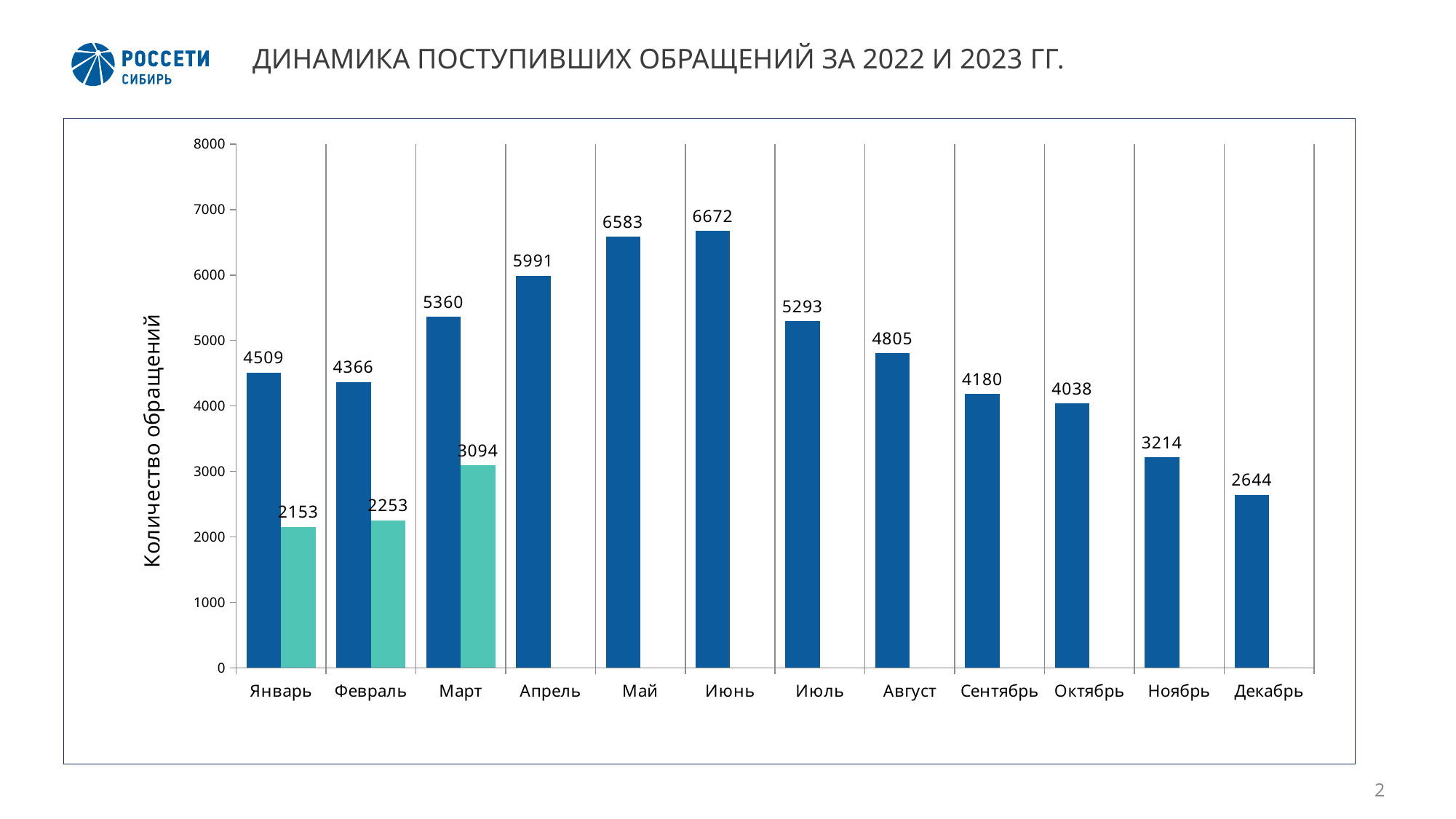
What is the value of the teal bar for Март? 3094 How many months are shown on the x axis? 12 What is the difference between the dark blue and teal bars for Январь? 2356 What is the value of the dark blue bar for Июнь? 6672 What type of chart is shown on the slide? bar chart Which is larger, the dark blue bar for Июль or the dark blue bar for Август? Июль What is the label of the vertical axis? Количество обращений Is the value of the dark blue bar for Ноябрь greater or less than 3000? greater Which month has the lowest dark blue bar? Декабрь Which month has the highest dark blue bar? Июнь What is the difference between the dark blue bars for Май and Апрель? 592 What is the value of the dark blue bar for Декабрь? 2644